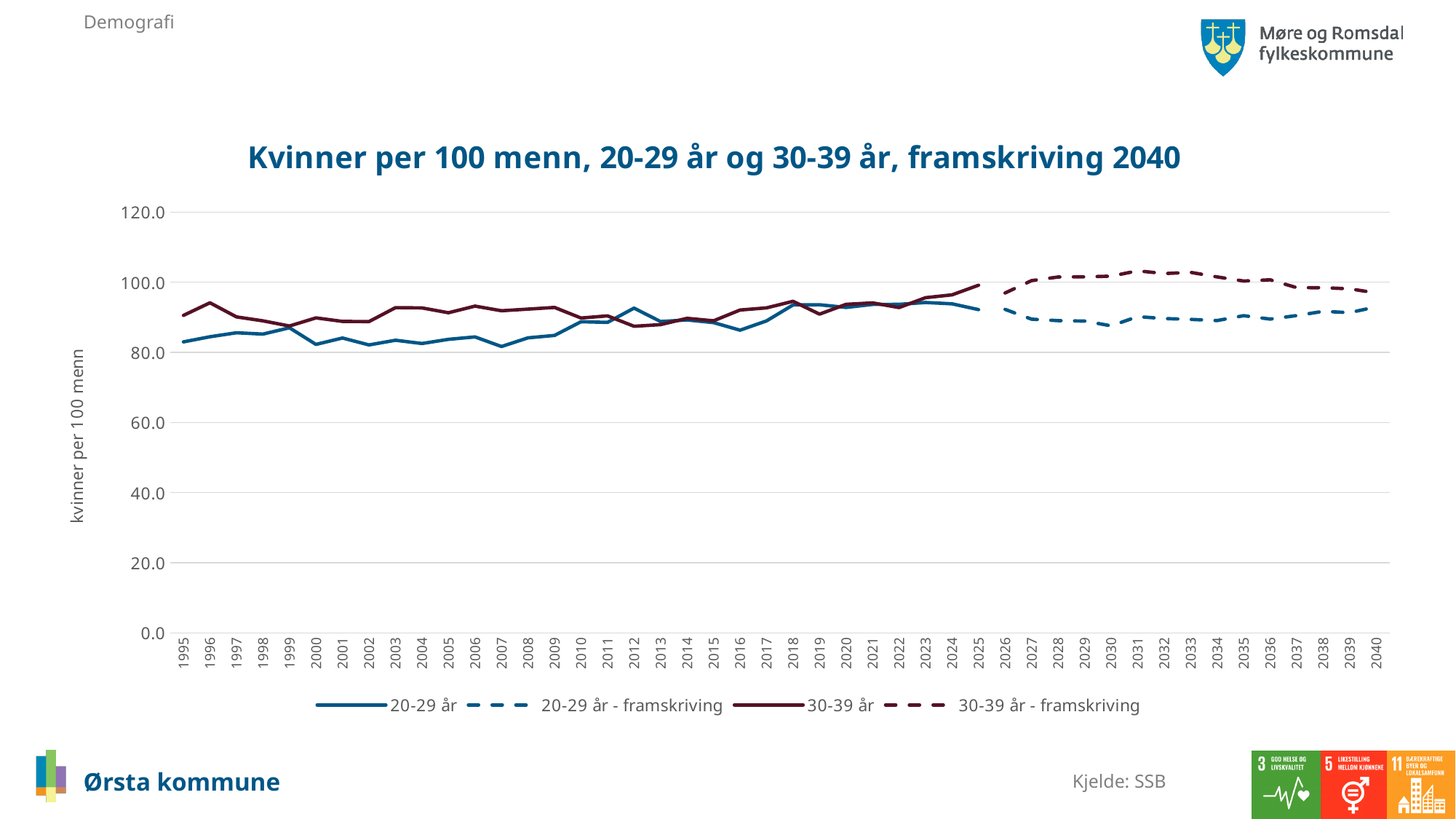
Is the value for 30-39 år in 1996 greater or less than 100? less Does the 30-39 år series rise or fall overall from 1995 to 2025? rise What is the title of the chart? Kvinner per 100 menn, 20-29 år og 30-39 år, framskriving 2040 Is the value for 20-29 år in 2012 greater or less than 80? greater In 2030, which series has the higher value, 20-29 år - framskriving or 30-39 år - framskriving? 30-39 år - framskriving How many series does the legend list? 4 In 2000, which series has the higher value, 20-29 år or 30-39 år? 30-39 år How many years are shown along the x axis? 46 Is the value for 20-29 år - framskriving in 2040 greater or less than 100? less What kind of chart is shown on the slide? line chart What is the label on the vertical axis? kvinner per 100 menn